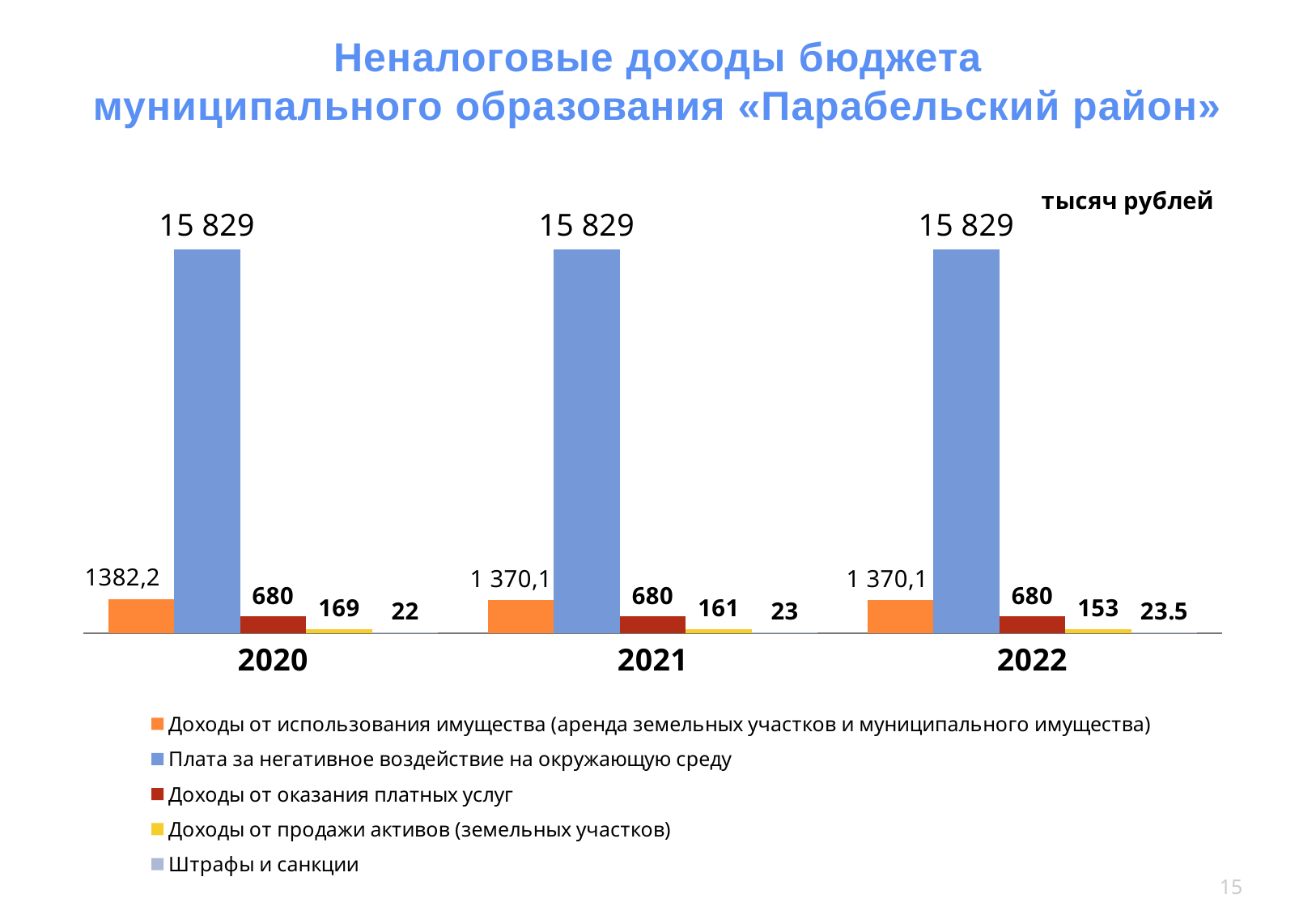
What kind of chart is shown on the slide? bar chart What is the value for «Доходы от продажи активов (земельных участков)» in 2021? 161 How many series does the legend list? 5 Do the values for «Доходы от продажи активов (земельных участков)» rise or fall from 2020 to 2022? fall How many years are shown on the x axis? 3 What is the difference between the values for «Доходы от продажи активов (земельных участков)» in 2020 and 2022? 16 What is the value for «Штрафы и санкции» in 2022? 23.5 Which series has the highest value in 2020? Плата за негативное воздействие на окружающую среду Which year has the larger value for «Штрафы и санкции», 2020 or 2021? 2021 What is the value for «Доходы от использования имущества» in 2020? 1382,2 In which year is the value for «Доходы от продажи активов (земельных участков)» the lowest? 2022 What is the value for «Плата за негативное воздействие на окружающую среду» in 2022? 15 829